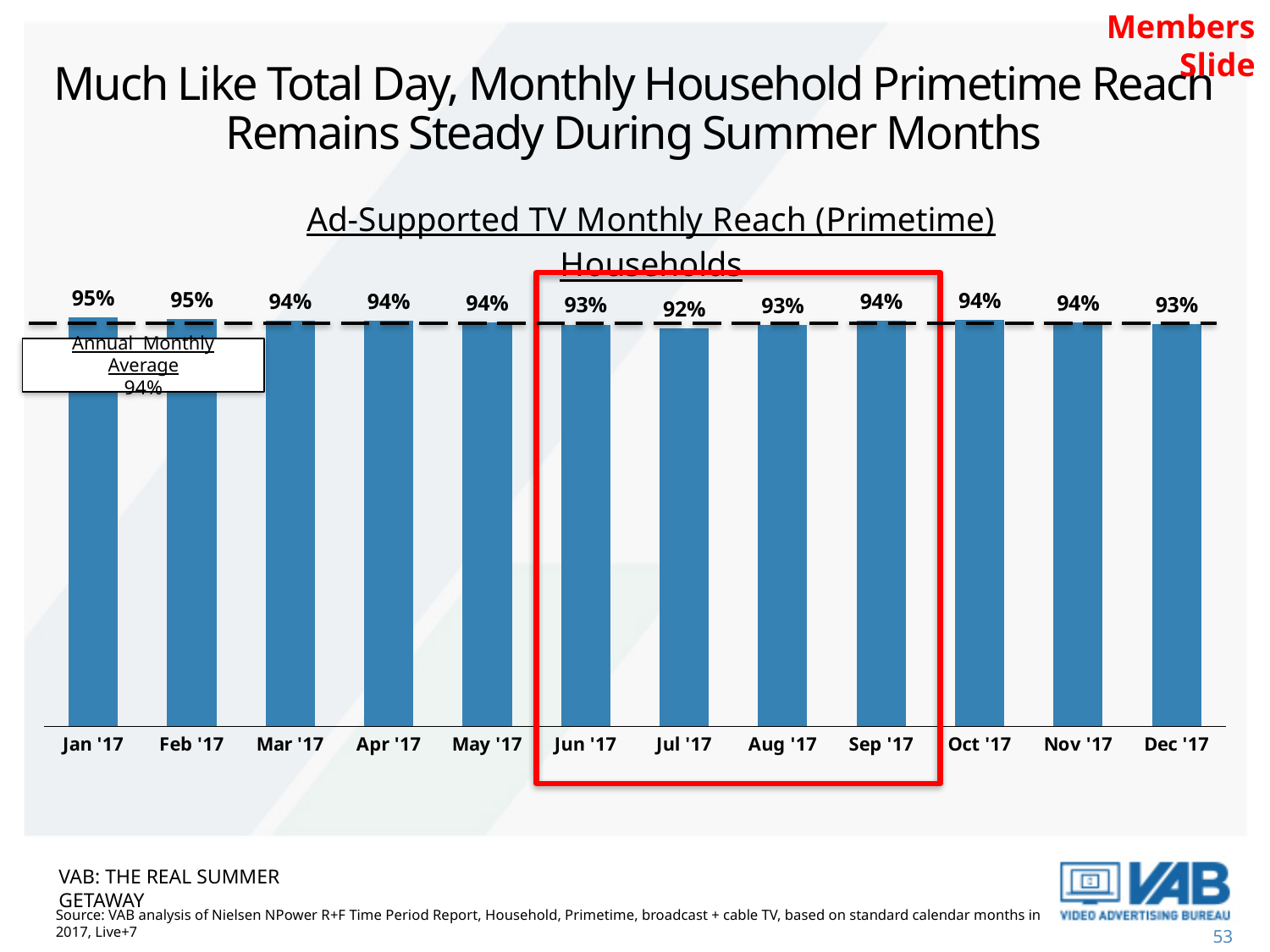
Which is larger, the value for Feb '17 or the value for Aug '17? Feb '17 Which month has the lowest monthly reach value? Jul '17 What is the Annual Monthly Average shown by the dashed line on the chart? 94% What is the difference between the Feb '17 value and the Jun '17 value? 2% What is the monthly reach value for Sep '17? 94% What is the monthly reach value for Jan '17? 95% How many months are shown on the x axis of the chart? 12 What is the difference between the Jan '17 value and the Jul '17 value? 3% What is the monthly reach value for Jul '17? 92% What kind of chart is shown on the slide? Bar chart What is the monthly reach value for Dec '17? 93% What is the title of the chart? Ad-Supported TV Monthly Reach (Primetime) Households